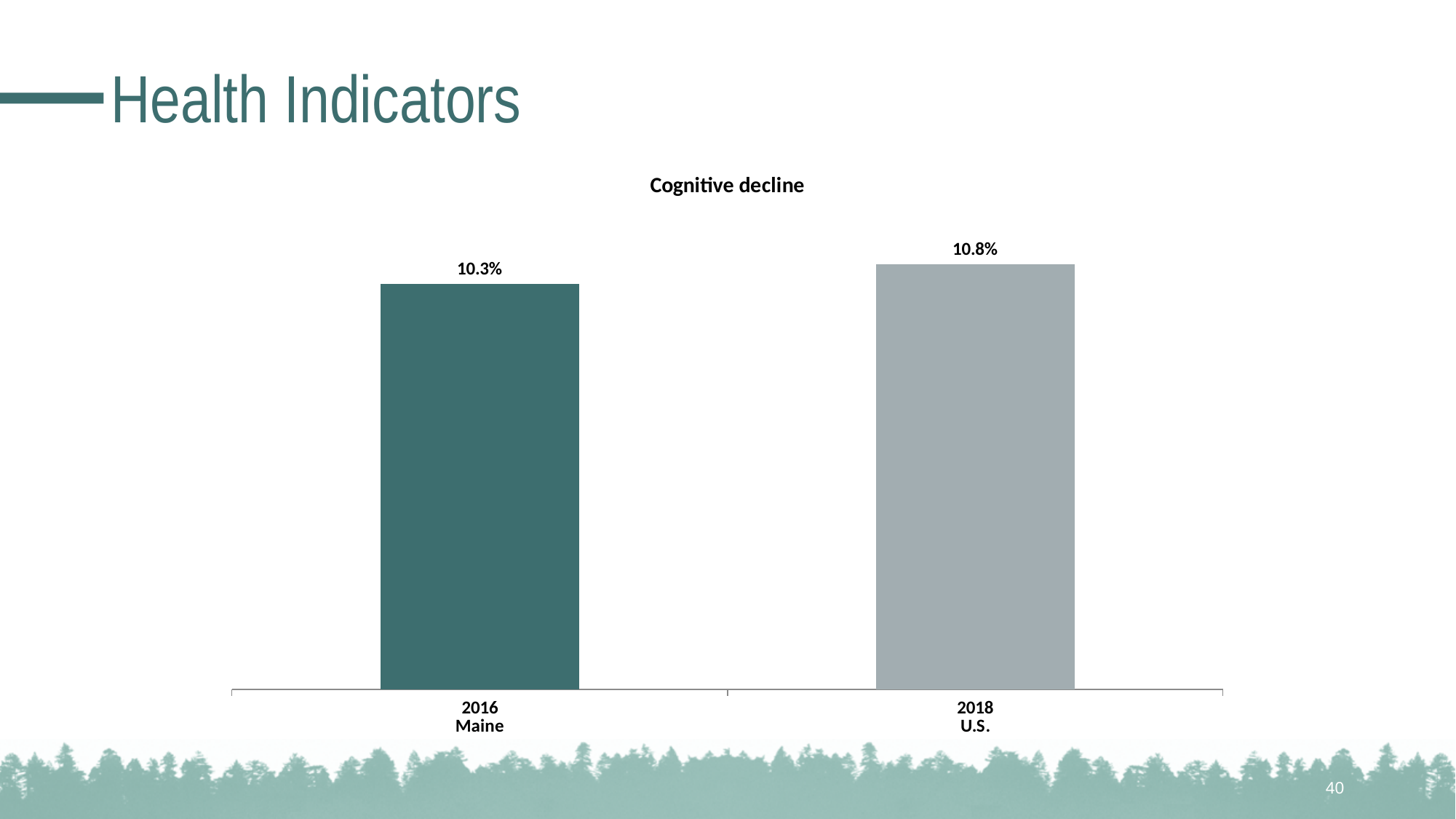
Do the values rise or fall from the left bar to the right bar in the Cognitive decline chart? Rise What colour is the bar for 2016 Maine in the Cognitive decline chart? Dark teal What is the value for 2018 U.S. in the Cognitive decline chart? 10.8% What kind of chart is shown on the slide? Bar chart Which category has the highest value in the Cognitive decline chart? 2018 U.S. Which category has the lowest value in the Cognitive decline chart? 2016 Maine How many bars are shown in the Cognitive decline chart? 2 What is the difference between the 2018 U.S. value and the 2016 Maine value in the Cognitive decline chart? 0.5% What is the title of the chart on the slide? Cognitive decline Which is larger in the Cognitive decline chart: the value for 2016 Maine or the value for 2018 U.S.? 2018 U.S. What is the value for 2016 Maine in the Cognitive decline chart? 10.3%